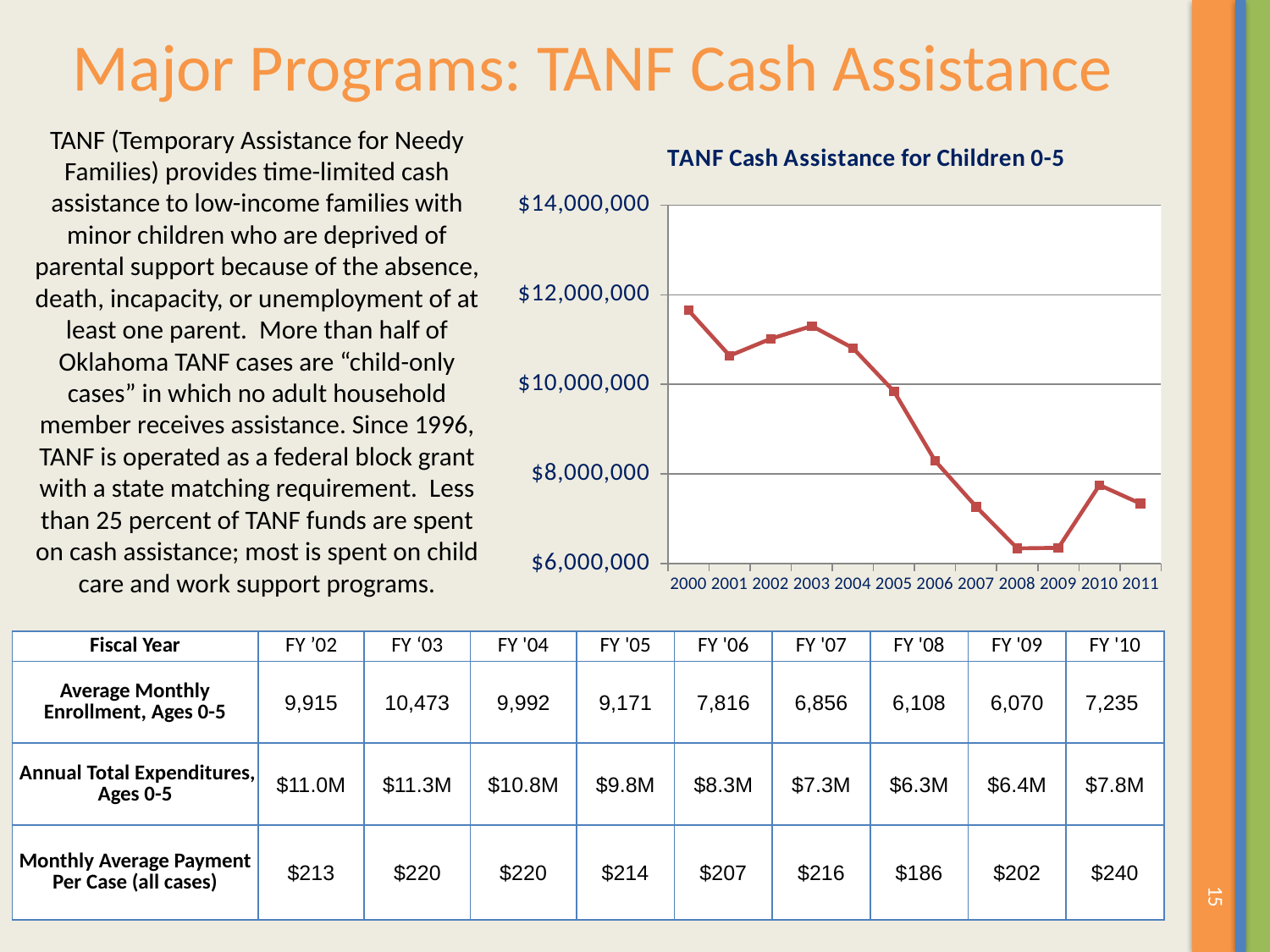
Is the value for 2008 greater or less than $8,000,000? less What is the title of the chart? TANF Cash Assistance for Children 0-5 Which is larger, the value for 2000 or the value for 2011? 2000 What kind of chart is shown on the slide? line chart Is the value for 2003 greater or less than $10,000,000? greater What is the highest value shown on the y axis of the chart? $14,000,000 Which year has the highest value in the chart? 2000 Is the value for 2006 greater or less than $8,000,000? greater How many years are plotted on the x axis of the chart? 12 Which is larger, the value for 2010 or the value for 2008? 2010 Do the values generally rise or fall from 2000 to 2009? fall